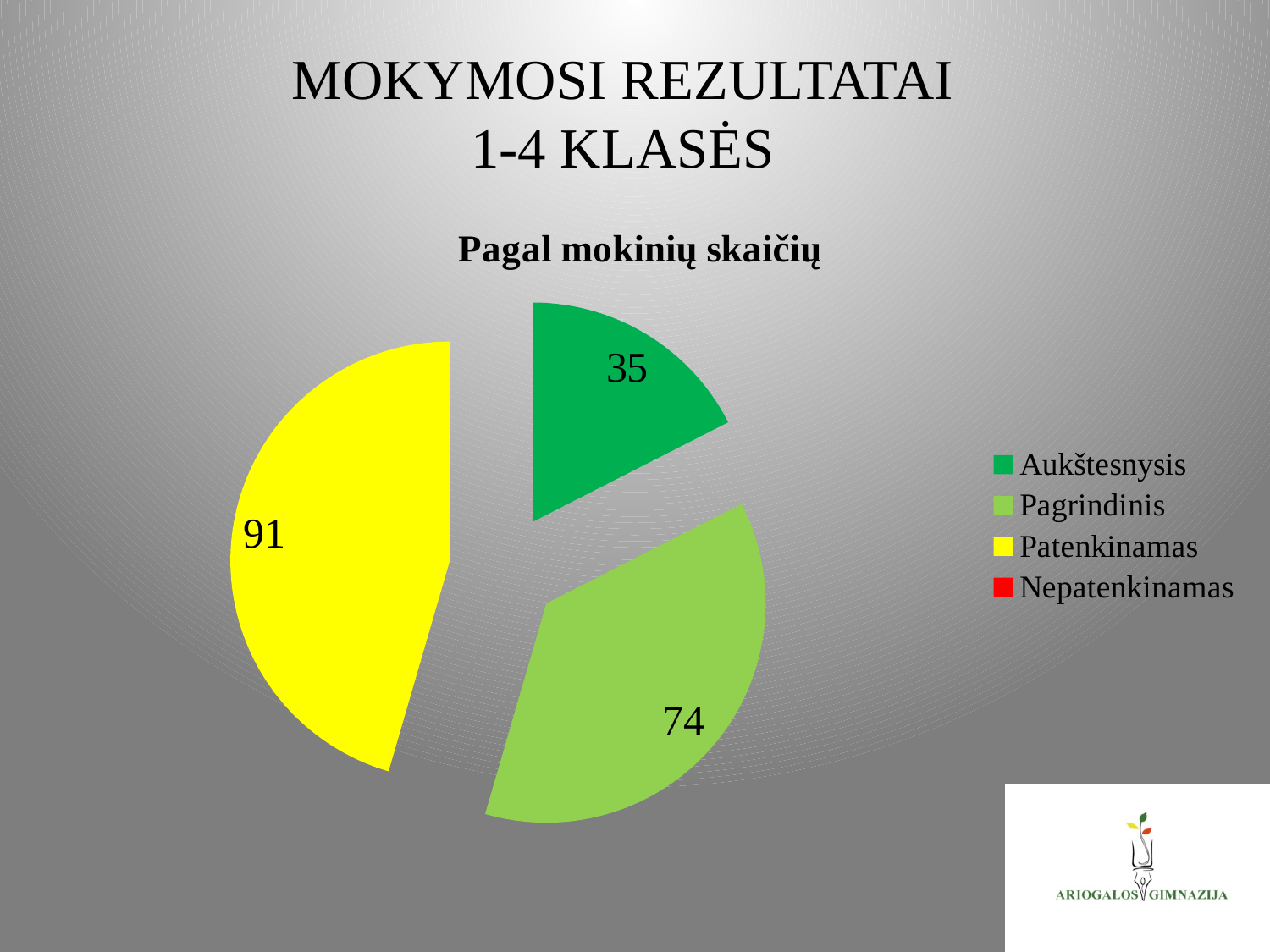
What is the title of the chart? Pagal mokinių skaičių What is the value of the Pagrindinis slice in the pie chart? 74 What colour is the Patenkinamas slice? Yellow What is the value of the Aukštesnysis slice in the pie chart? 35 Which is larger, the Pagrindinis slice or the Aukštesnysis slice? Pagrindinis What kind of chart is shown on the slide? Pie chart What is the difference between the Patenkinamas and Pagrindinis values? 17 What is the difference between the Pagrindinis and Aukštesnysis values? 39 Which category has the largest slice in the pie chart? Patenkinamas What is the value of the Patenkinamas slice in the pie chart? 91 How many entries does the chart legend list? 4 Which of the labeled slices in the pie chart is the smallest? Aukštesnysis